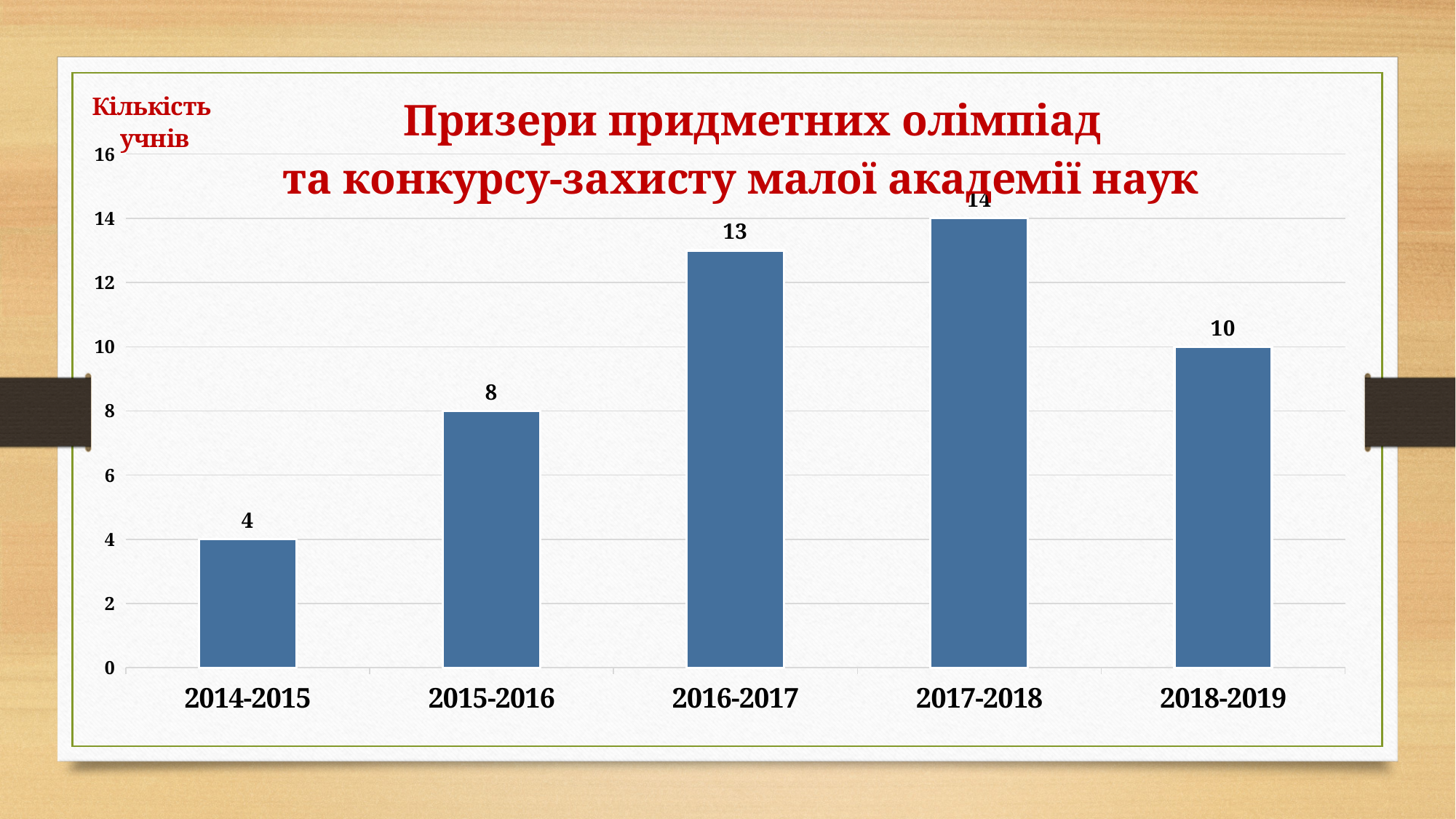
What is the value for 2016-2017? 13 What is the difference between the values for 2017-2018 and 2015-2016? 6 Which year has the lowest value? 2014-2015 What kind of chart is shown on the slide? bar chart How many years are shown on the x axis? 5 Which is larger, the value for 2016-2017 or the value for 2018-2019? 2016-2017 What is the label on the vertical axis? Кількість учнів What is the value for 2014-2015? 4 Do the values rise or fall from 2014-2015 to 2017-2018? rise Which year has the highest value? 2017-2018 What is the value for 2018-2019? 10 Is the value for 2015-2016 greater or less than 6? greater